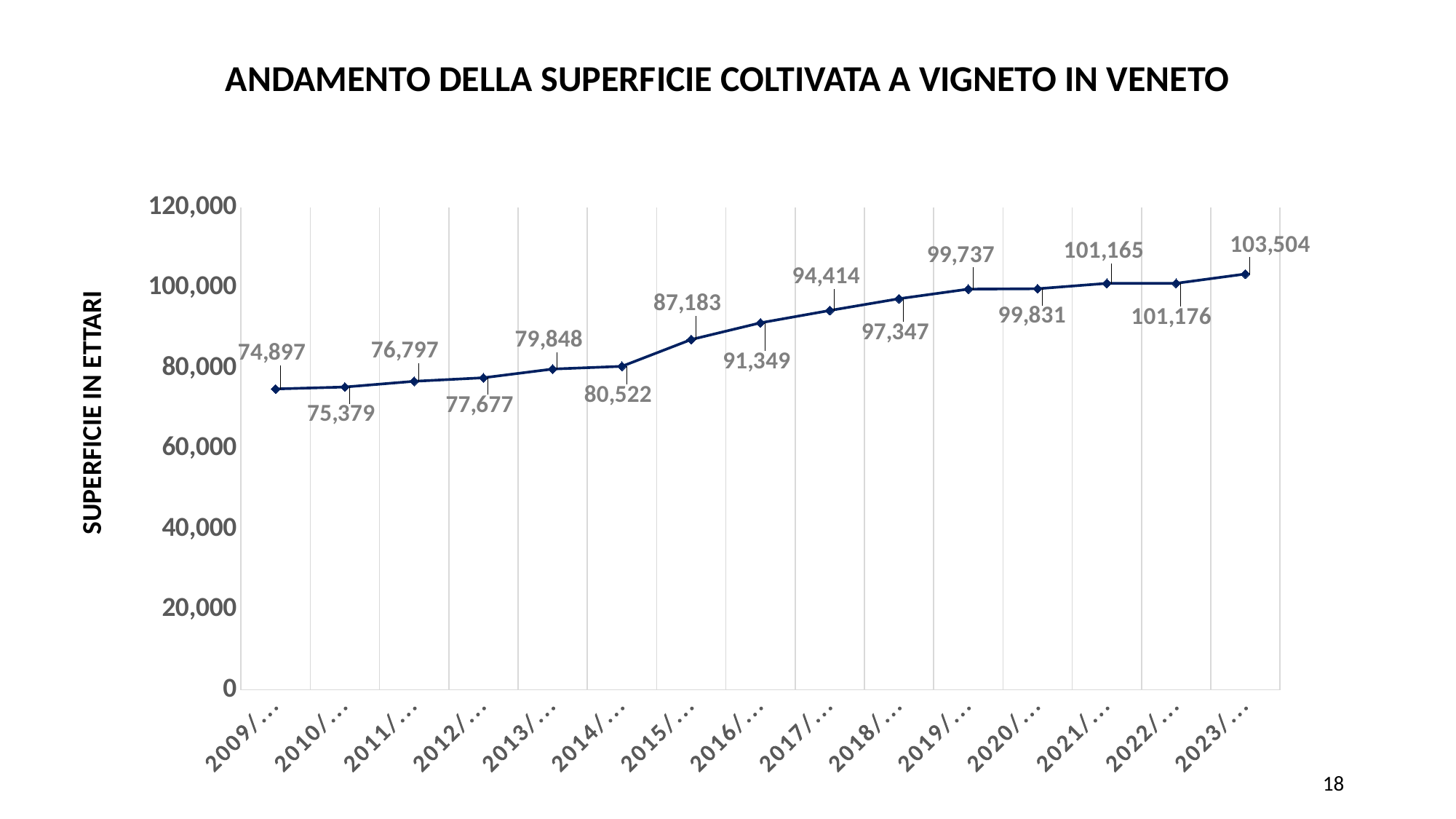
What is the difference between the values for 2023/… and 2009/…? 28,607 Which category has the highest value? 2023/… What is the value for the category labelled 2009/…? 74,897 What is the value for the category labelled 2015/…? 87,183 What is the value for the category labelled 2023/…? 103,504 Which is larger, the value for 2017/… or the value for 2016/…? 2017/… What is the difference between the values for 2015/… and 2014/…? 6,661 How many data points are plotted on the line? 15 Which category has the lowest value? 2009/… Do the values rise or fall from left to right along the x axis? rise What kind of chart is shown on the slide? line chart What is the label of the vertical axis? SUPERFICIE IN ETTARI